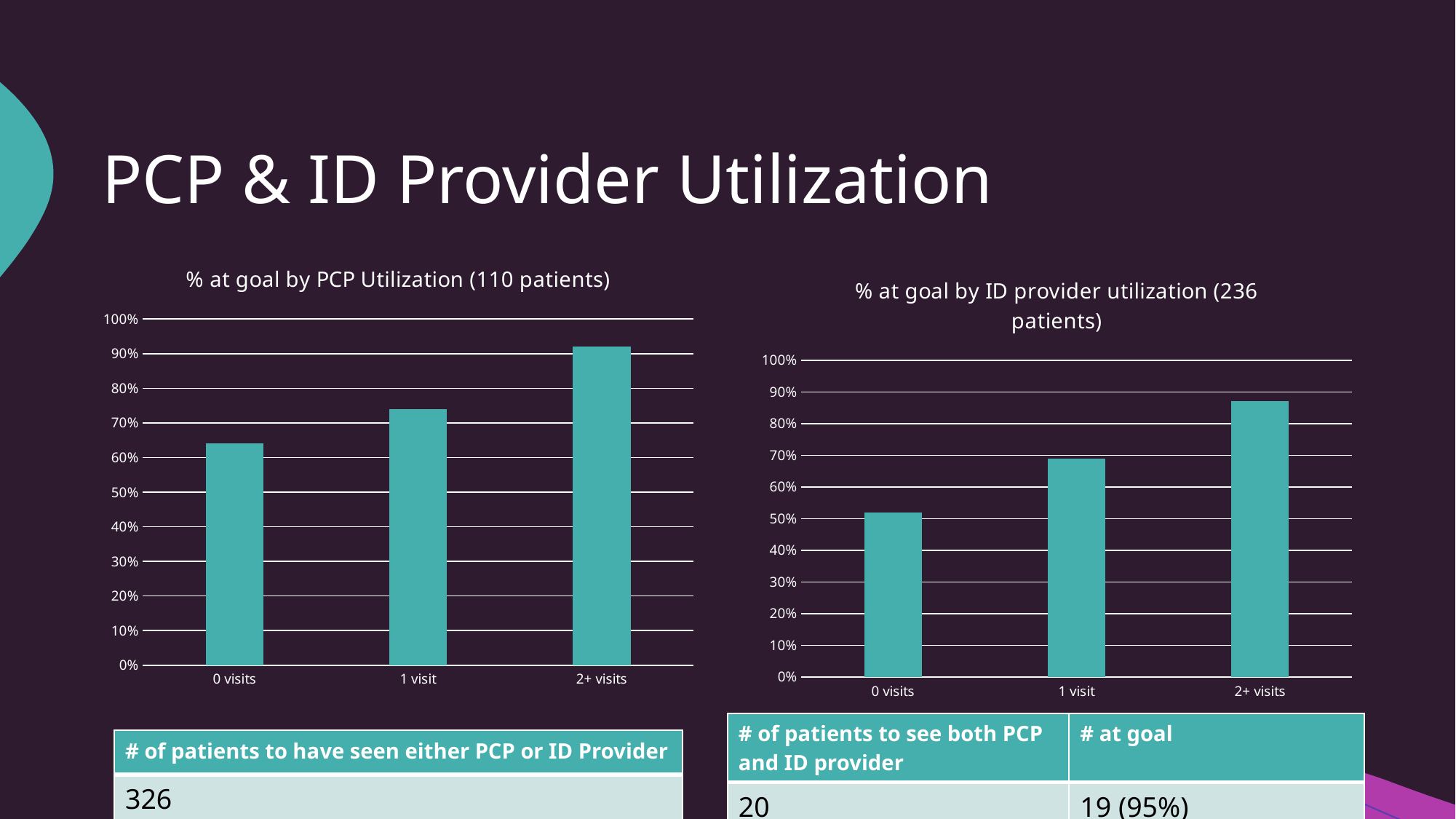
What is the title of the chart on the left of the slide? % at goal by PCP Utilization (110 patients) In the '% at goal by PCP Utilization (110 patients)' chart, do the values rise or fall from 0 visits to 2+ visits? rise In the '% at goal by ID provider utilization (236 patients)' chart, is the value for 2+ visits greater or less than 90%? less In the '% at goal by ID provider utilization (236 patients)' chart, which is larger, the value for 1 visit or the value for 0 visits? 1 visit In the '% at goal by ID provider utilization (236 patients)' chart, is the value for 0 visits greater or less than 60%? less In the '% at goal by PCP Utilization (110 patients)' chart, is the value for 2+ visits greater or less than 80%? greater How many categories are shown in the '% at goal by ID provider utilization (236 patients)' chart? 3 In the '% at goal by ID provider utilization (236 patients)' chart, which category has the lowest value? 0 visits In the '% at goal by PCP Utilization (110 patients)' chart, which category has the lowest value? 0 visits What kind of chart is '% at goal by PCP Utilization (110 patients)'? bar chart In the '% at goal by PCP Utilization (110 patients)' chart, which category has the highest value? 2+ visits